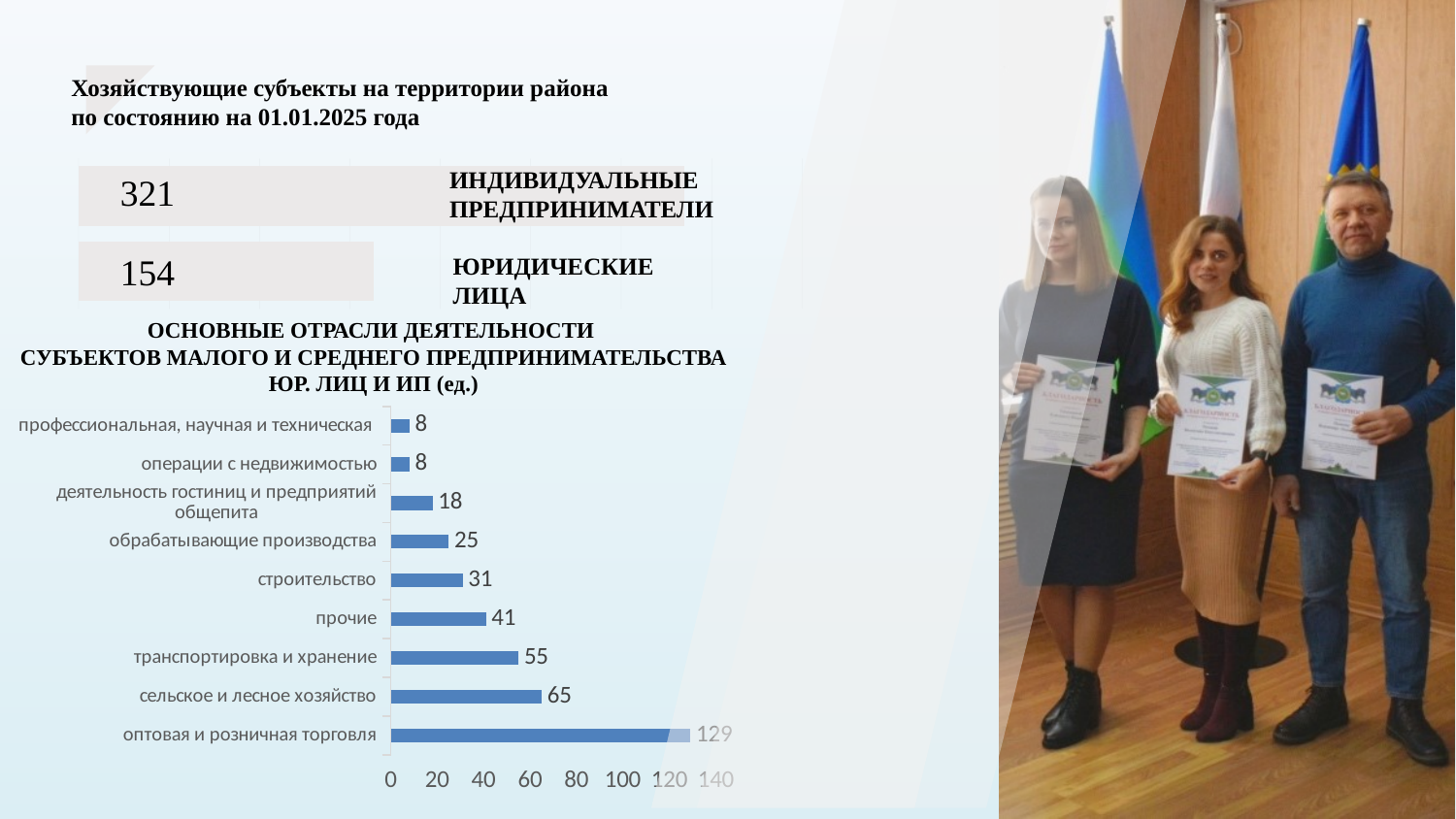
What is the value for строительство? 31 What is the value for транспортировка и хранение? 55 What is the difference between прочие and обрабатывающие производства? 16 What is the value for сельское и лесное хозяйство? 65 Is the value for сельское и лесное хозяйство greater or less than 60? greater What kind of chart is shown on the slide? bar chart What is the value for оптовая и розничная торговля? 129 How many categories are shown in the chart? 9 What is the difference between оптовая и розничная торговля and сельское и лесное хозяйство? 64 What is the value for деятельность гостиниц и предприятий общепита? 18 Which is larger, транспортировка и хранение or строительство? транспортировка и хранение Which category has the highest value? оптовая и розничная торговля